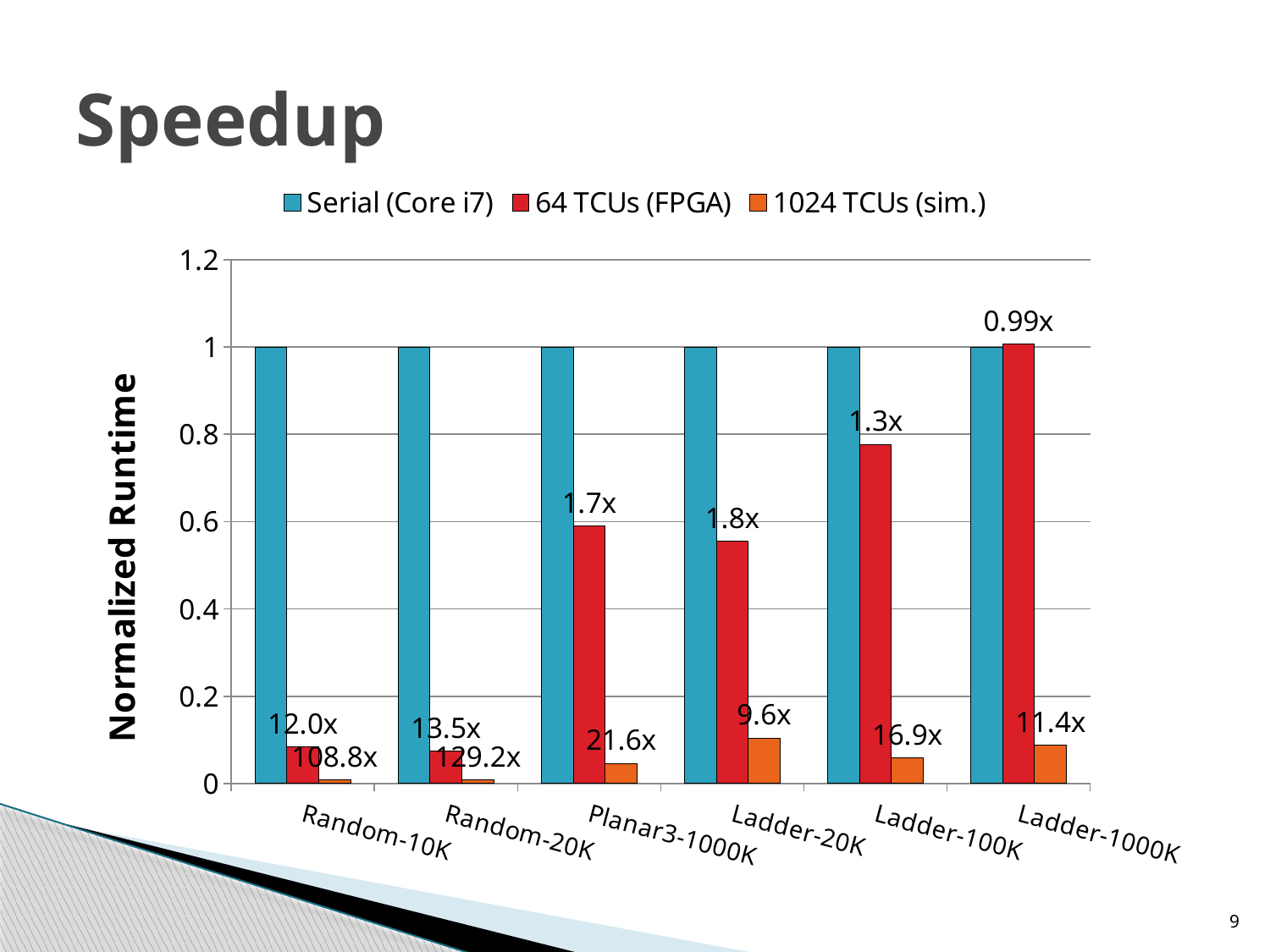
Which category has the highest speedup label for the 1024 TCUs (sim.) series? Random-20K How many categories are shown on the x axis? 6 Which category has the lowest speedup label for the 64 TCUs (FPGA) series? Ladder-1000K What is the difference between the 1024 TCUs (sim.) speedup labels for Random-20K and Random-10K? 20.4x What is the normalized runtime of the Serial (Core i7) bar for Planar3-1000K? 1 What kind of chart is shown on the slide? bar chart What speedup label is shown on the 1024 TCUs (sim.) bar for Random-20K? 129.2x What speedup label is shown on the 64 TCUs (FPGA) bar for Ladder-1000K? 0.99x What speedup label is shown on the 64 TCUs (FPGA) bar for Random-10K? 12.0x What is the label of the y axis? Normalized Runtime Is the normalized runtime of the 64 TCUs (FPGA) bar for Ladder-20K greater or less than 0.6? less How many series does the legend list? 3